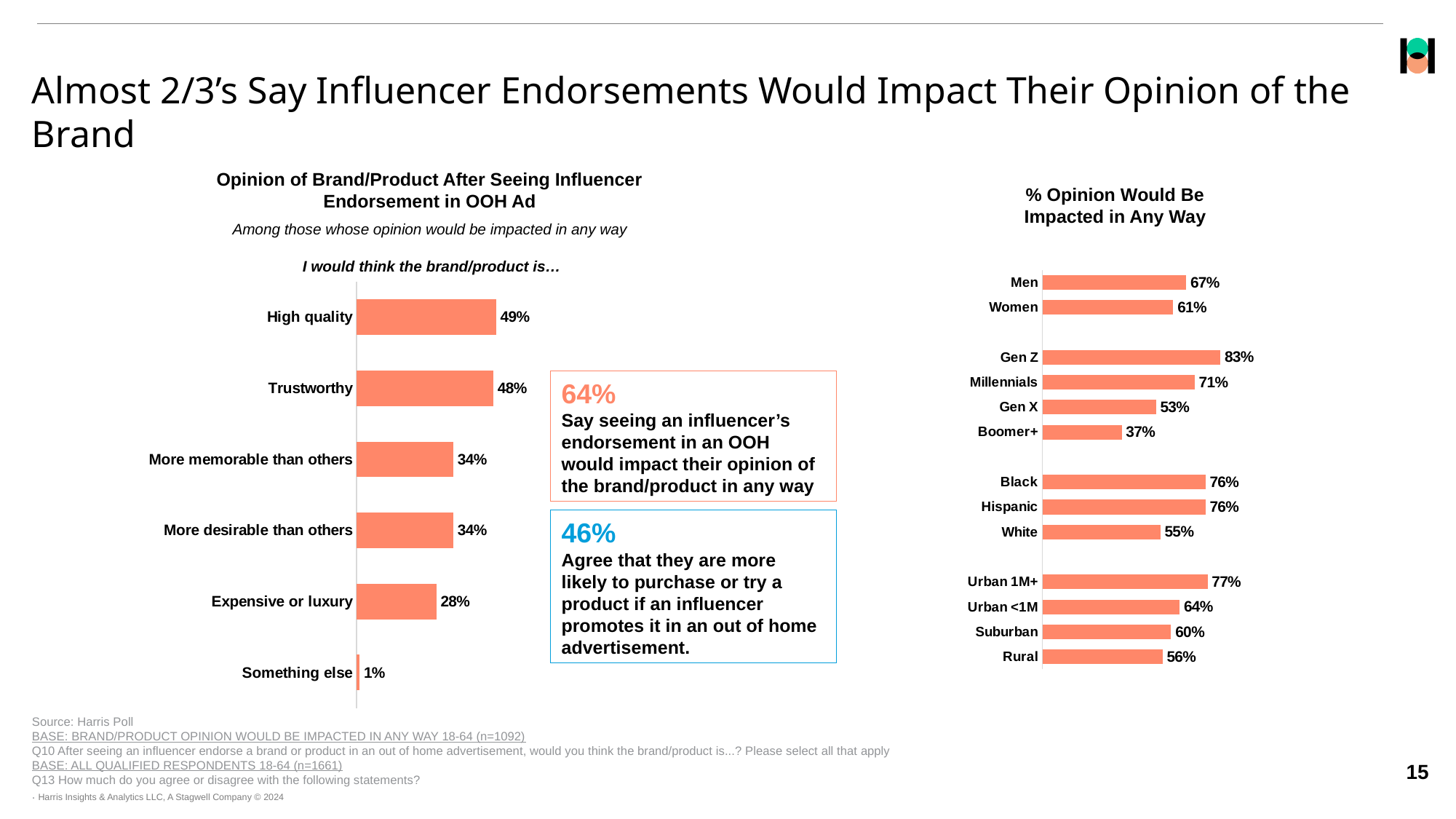
In the '% Opinion Would Be Impacted in Any Way' chart, what is the value for Rural? 56% In the 'Opinion of Brand/Product After Seeing Influencer Endorsement in OOH Ad' chart, how many categories are shown? 6 In the 'Opinion of Brand/Product After Seeing Influencer Endorsement in OOH Ad' chart, which category has the lowest value? Something else In the 'Opinion of Brand/Product After Seeing Influencer Endorsement in OOH Ad' chart, what percentage would think the brand/product is high quality? 49% In the '% Opinion Would Be Impacted in Any Way' chart, what is the difference between Millennials and Gen X? 18% In the '% Opinion Would Be Impacted in Any Way' chart, which is larger, Men or Women? Men In the '% Opinion Would Be Impacted in Any Way' chart, what is the value for Gen Z? 83% What type of chart is the '% Opinion Would Be Impacted in Any Way' chart? Bar chart In the '% Opinion Would Be Impacted in Any Way' chart, which category has the highest value? Gen Z In the 'Opinion of Brand/Product After Seeing Influencer Endorsement in OOH Ad' chart, what is the difference between 'High quality' and 'Expensive or luxury'? 21% In the 'Opinion of Brand/Product After Seeing Influencer Endorsement in OOH Ad' chart, what percentage would think the brand/product is expensive or luxury? 28% In the '% Opinion Would Be Impacted in Any Way' chart, which category has the lowest value? Boomer+